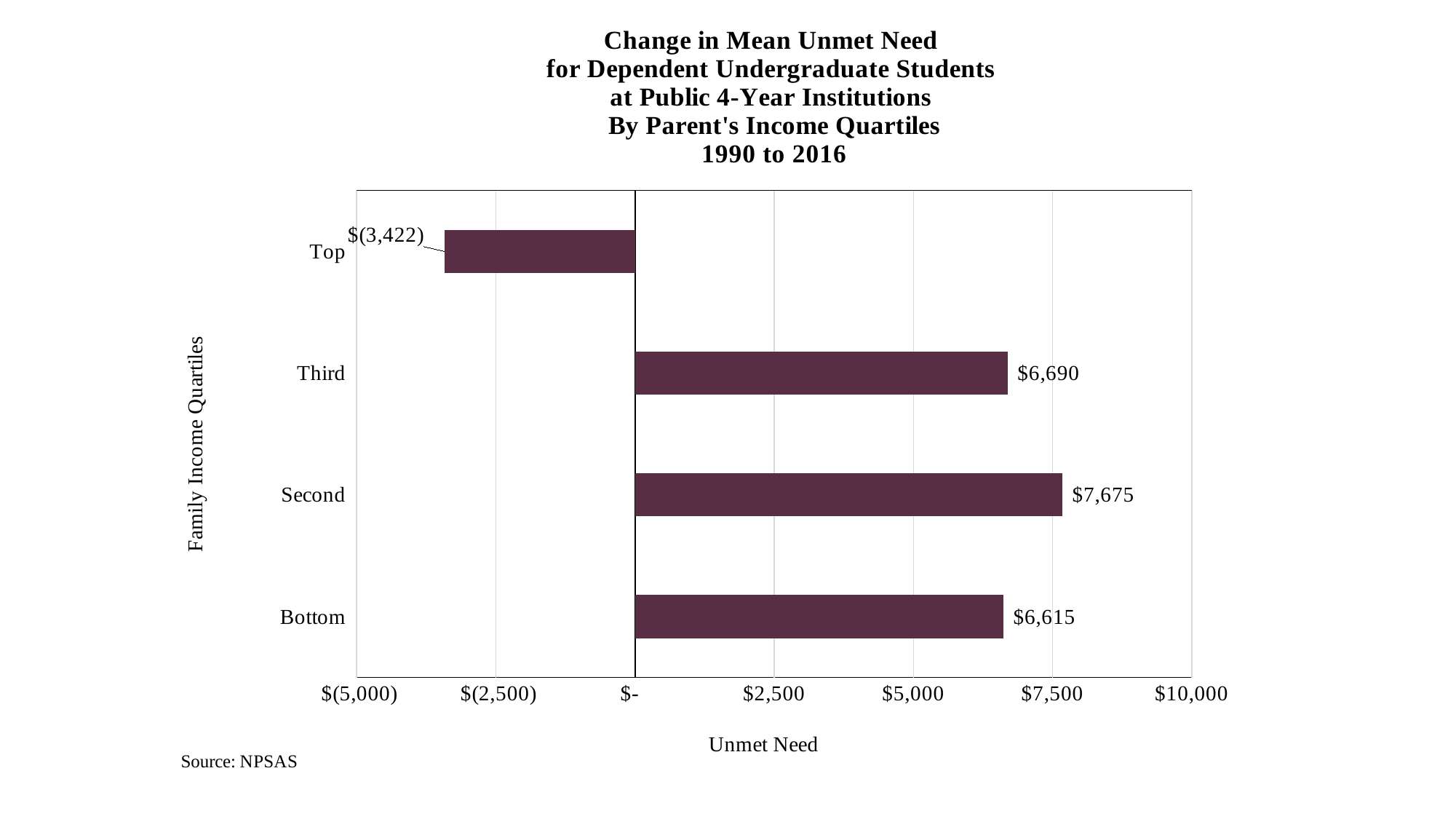
What is the change in mean unmet need for the Top income quartile? $(3,422) Which income quartile has the highest change in mean unmet need? Second What is the label of the horizontal axis? Unmet Need What is the difference between the values for the Second and Third quartiles? $985 What is the change in mean unmet need for the Third income quartile? $6,690 What kind of chart is shown on the slide? Bar chart Which income quartile has the lowest change in mean unmet need? Top What is the difference between the values for the Third and Bottom quartiles? $75 Which has a larger change in mean unmet need, the Second quartile or the Bottom quartile? Second How many income quartiles are shown on the chart? 4 What is the change in mean unmet need for the Second income quartile? $7,675 What is the change in mean unmet need for the Bottom income quartile? $6,615